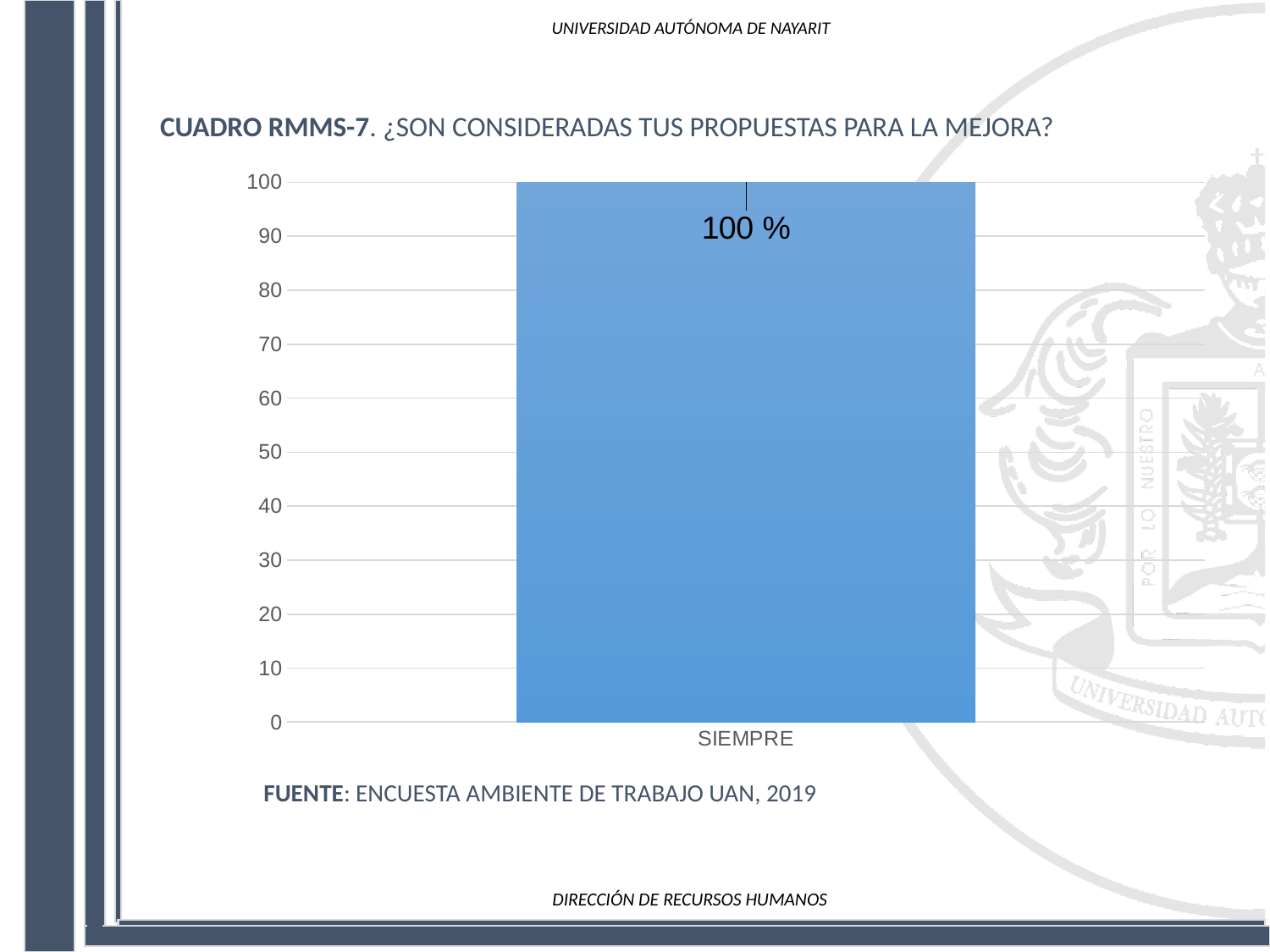
What kind of chart is shown on the slide? bar chart How many categories are plotted on the x axis? 1 What is the label of the only category on the x axis? SIEMPRE What is the value shown for SIEMPRE? 100 % Is the value for SIEMPRE greater or less than 50? greater Which category has the highest value? SIEMPRE What is the highest value shown on the vertical axis? 100